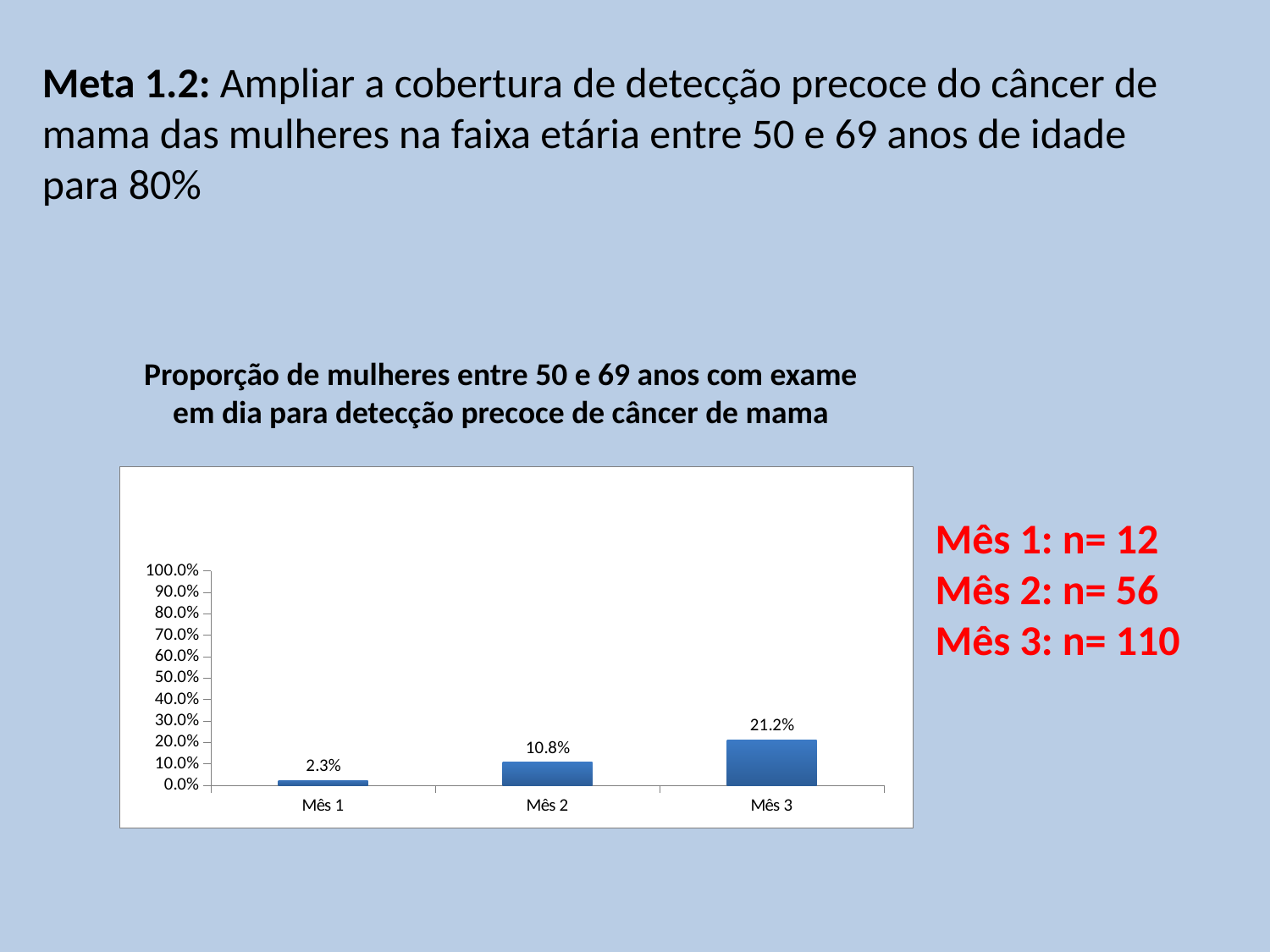
Which month has the lowest value? Mês 1 Which month has the highest value? Mês 3 What is the value for Mês 2? 10.8% Do the values rise or fall from Mês 1 to Mês 3? rise Is the value for Mês 3 greater or less than 30.0%? less How many categories are shown on the x axis? 3 What is the value for Mês 3? 21.2% What is the difference between the values for Mês 2 and Mês 1? 8.5% Which is larger, the value for Mês 2 or the value for Mês 3? Mês 3 What is the value for Mês 1? 2.3% What is the difference between the values for Mês 3 and Mês 2? 10.4% What kind of chart is shown on the slide? bar chart